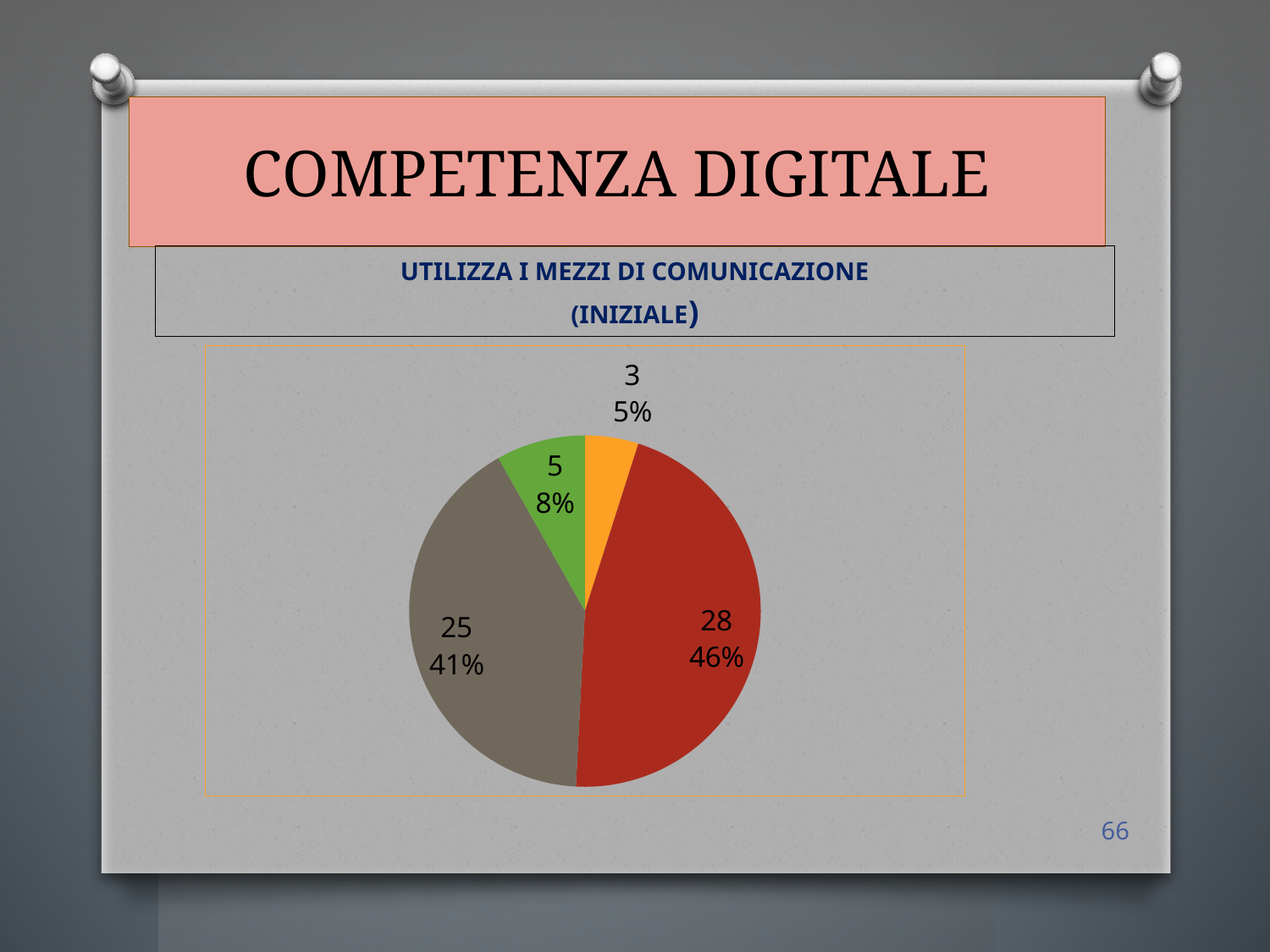
What percentage is shown on the grey slice of the pie chart? 41% What percentage is shown on the orange slice of the pie chart? 5% What is the difference between the values of the red slice and the grey slice? 3 What value is shown on the green slice of the pie chart? 5 Which is larger, the value of the green slice or the value of the orange slice? the green slice Which slice of the pie chart has the largest value? the red slice (28, 46%) What is the total of all the values shown on the pie chart? 61 What kind of chart is shown on the slide? pie chart Which slice of the pie chart has the smallest value? the orange slice (3, 5%) How many slices does the pie chart have? 4 What value is shown on the red slice of the pie chart? 28 What is the title shown above the pie chart? UTILIZZA I MEZZI DI COMUNICAZIONE (INIZIALE)